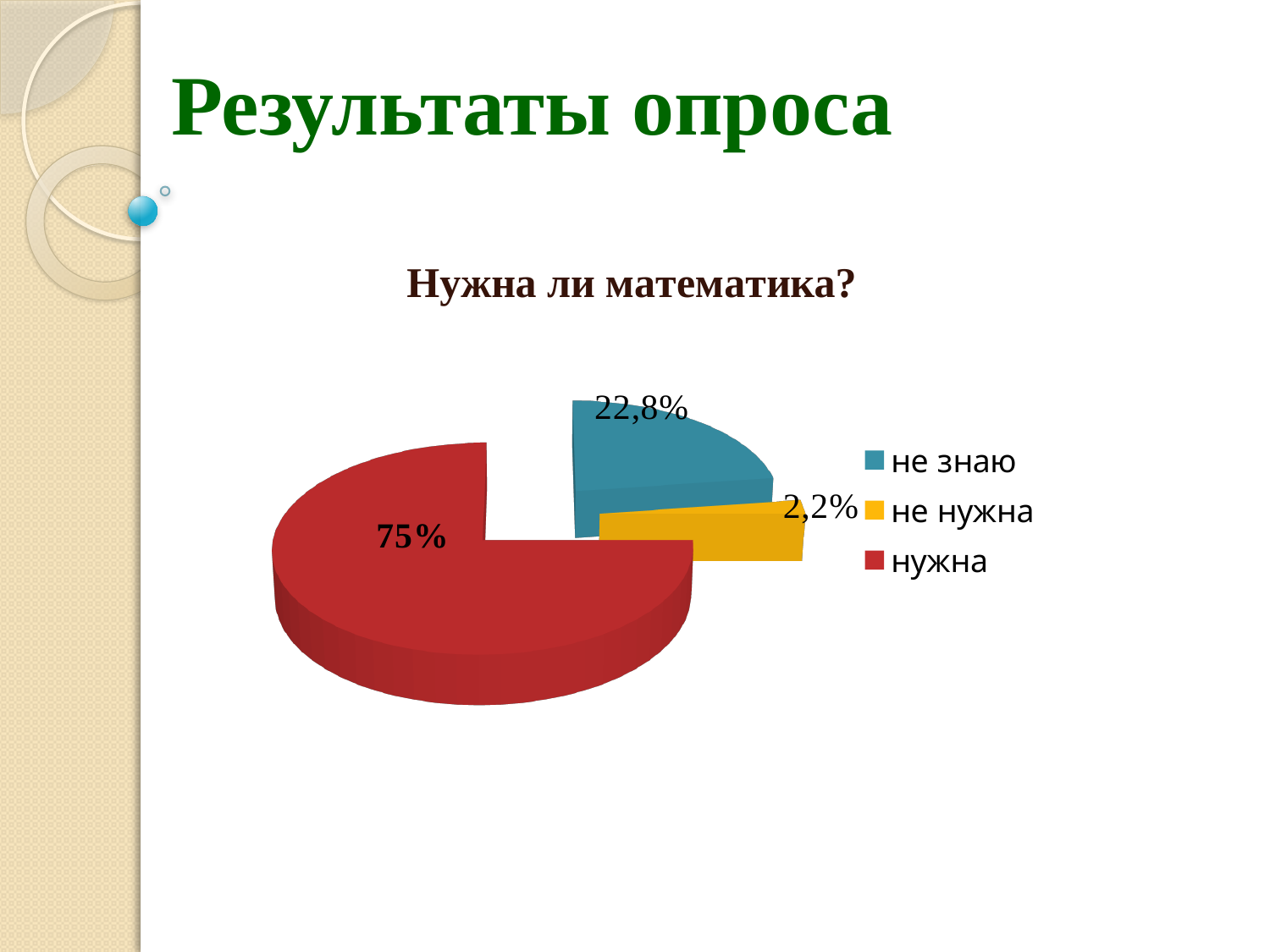
What percentage is shown for the "не знаю" slice? 22,8% What is the difference between the "не знаю" share and the "не нужна" share? 20,6% What is the title of the chart? Нужна ли математика? Which category has the largest share of the pie? нужна What kind of chart is shown on the slide? pie chart How many categories does the legend list? 3 Which is larger, the share for "не знаю" or the share for "не нужна"? не знаю What colour is the "нужна" slice? red Which category has the smallest share of the pie? не нужна What percentage is shown for the "нужна" slice? 75% What is the difference between the "нужна" share and the "не знаю" share? 52,2% What percentage is shown for the "не нужна" slice? 2,2%